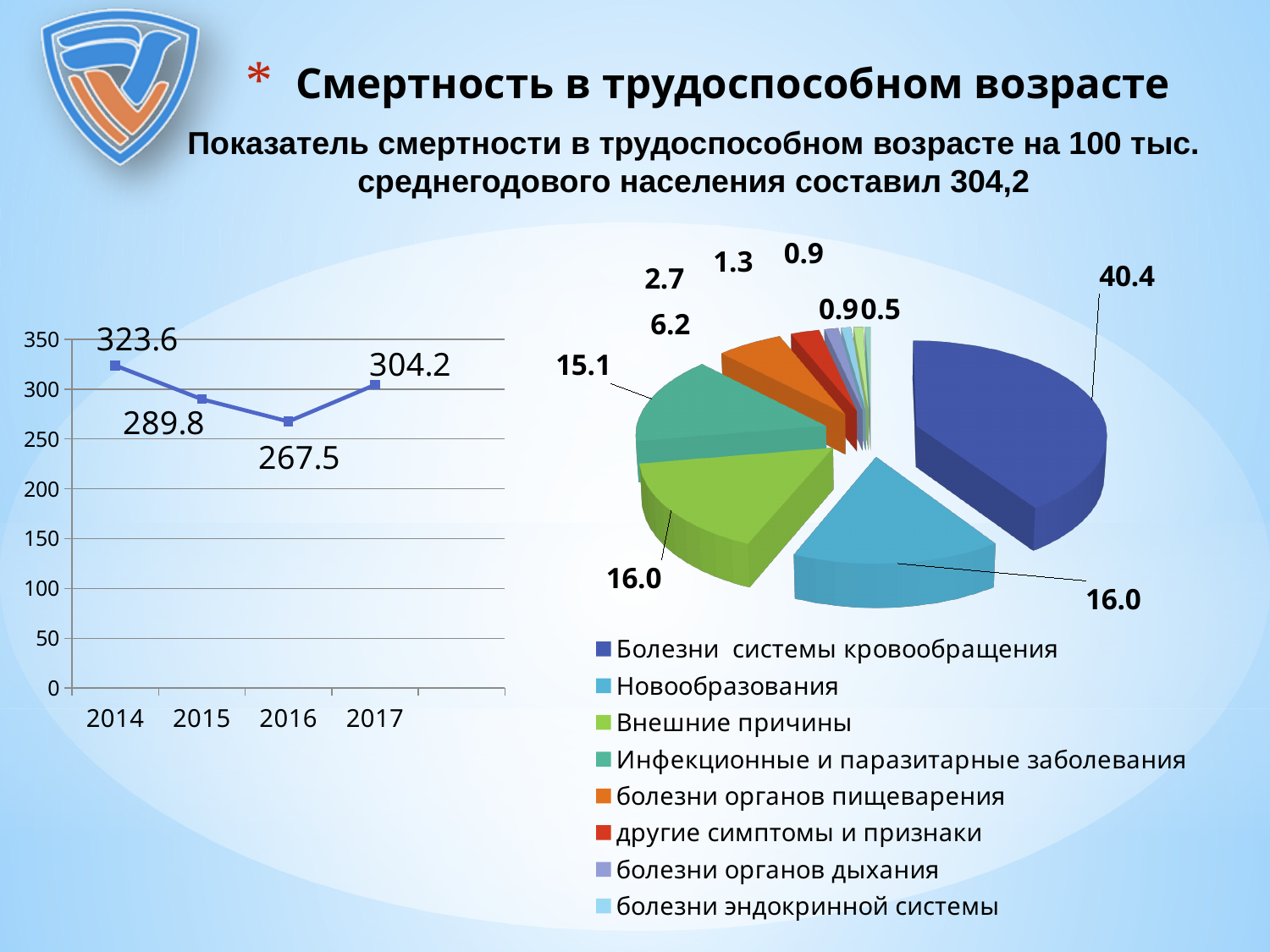
In the pie chart on the right, what is the value for Болезни системы кровообращения? 40.4 What kind of chart is shown on the left of the slide? line chart How many entries does the legend of the pie chart on the right list? 8 In the pie chart on the right, which category has the largest slice? Болезни системы кровообращения In the line chart on the left, which year has the lowest value? 2016 In the line chart on the left, what is the difference between the values for 2014 and 2017? 19.4 In the line chart on the left, do the values rise or fall from 2014 to 2016? fall In the line chart on the left, how many years are plotted? 4 In the line chart on the left, which is larger: the value for 2015 or the value for 2017? 2017 In the line chart on the left, what is the value for 2014? 323.6 In the line chart on the left, which year has the highest value? 2014 In the line chart on the left, what is the value for 2016? 267.5